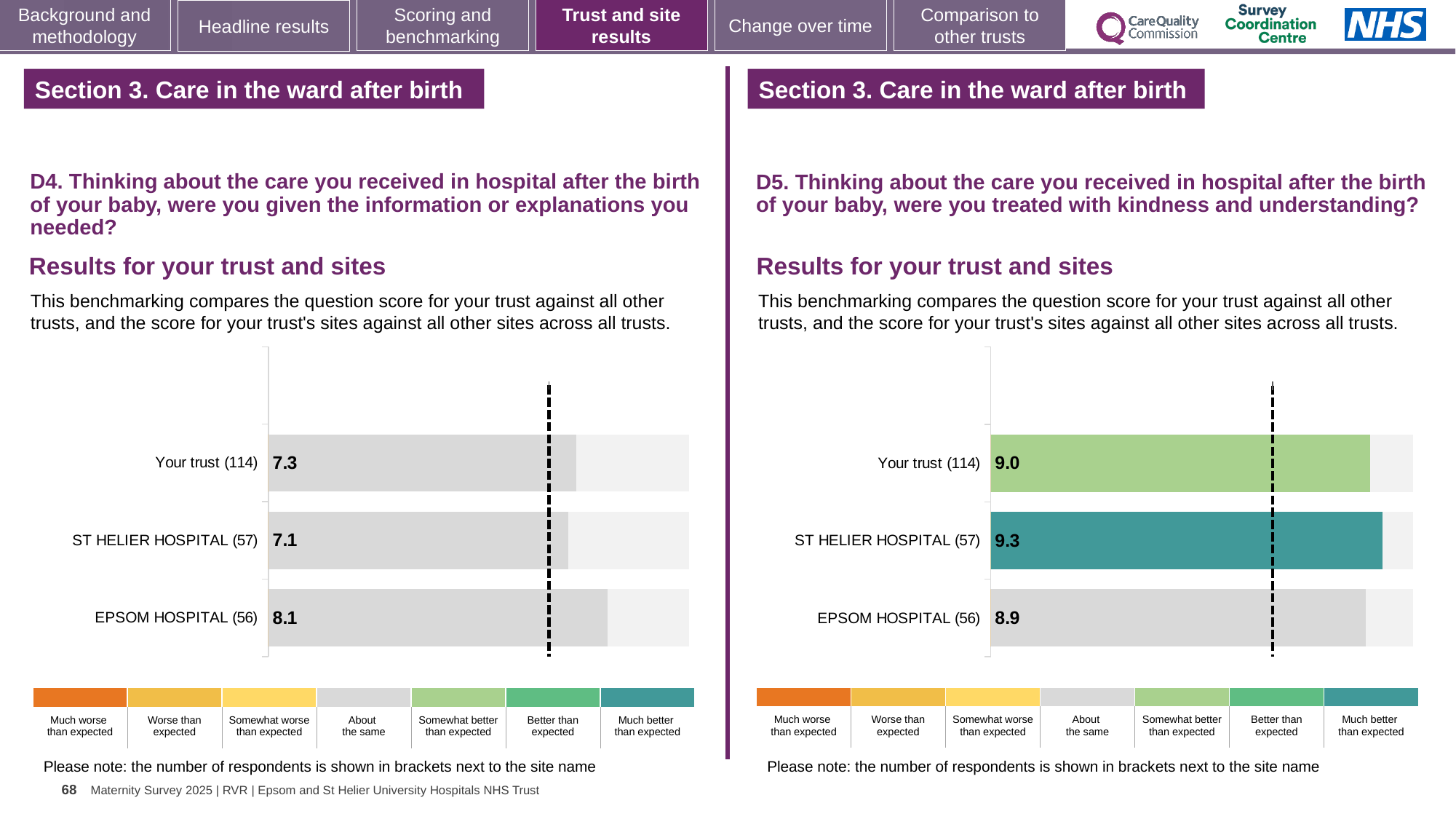
In the D5 chart on the right, which site or trust has the highest score? ST HELIER HOSPITAL (57) How many bars are shown in the D4 chart on the left? 3 In the D4 chart on the left, what is the score for EPSOM HOSPITAL (56)? 8.1 In the D4 chart on the left, which site or trust has the lowest score? ST HELIER HOSPITAL (57) In the D5 chart on the right, what is the difference between the scores for ST HELIER HOSPITAL (57) and Your trust (114)? 0.3 What type of chart is used for the D5 results on the right? Bar chart In the D5 chart on the right, what is the score for ST HELIER HOSPITAL (57)? 9.3 In the D5 chart on the right, which has the larger score, Your trust (114) or EPSOM HOSPITAL (56)? Your trust (114) In the D4 chart on the left, what is the score for Your trust (114)? 7.3 In the D4 chart on the left, which site or trust has the highest score? EPSOM HOSPITAL (56) In the D5 chart on the right, what is the score for EPSOM HOSPITAL (56)? 8.9 In the D4 chart on the left, what is the difference between the scores for EPSOM HOSPITAL (56) and ST HELIER HOSPITAL (57)? 1.0